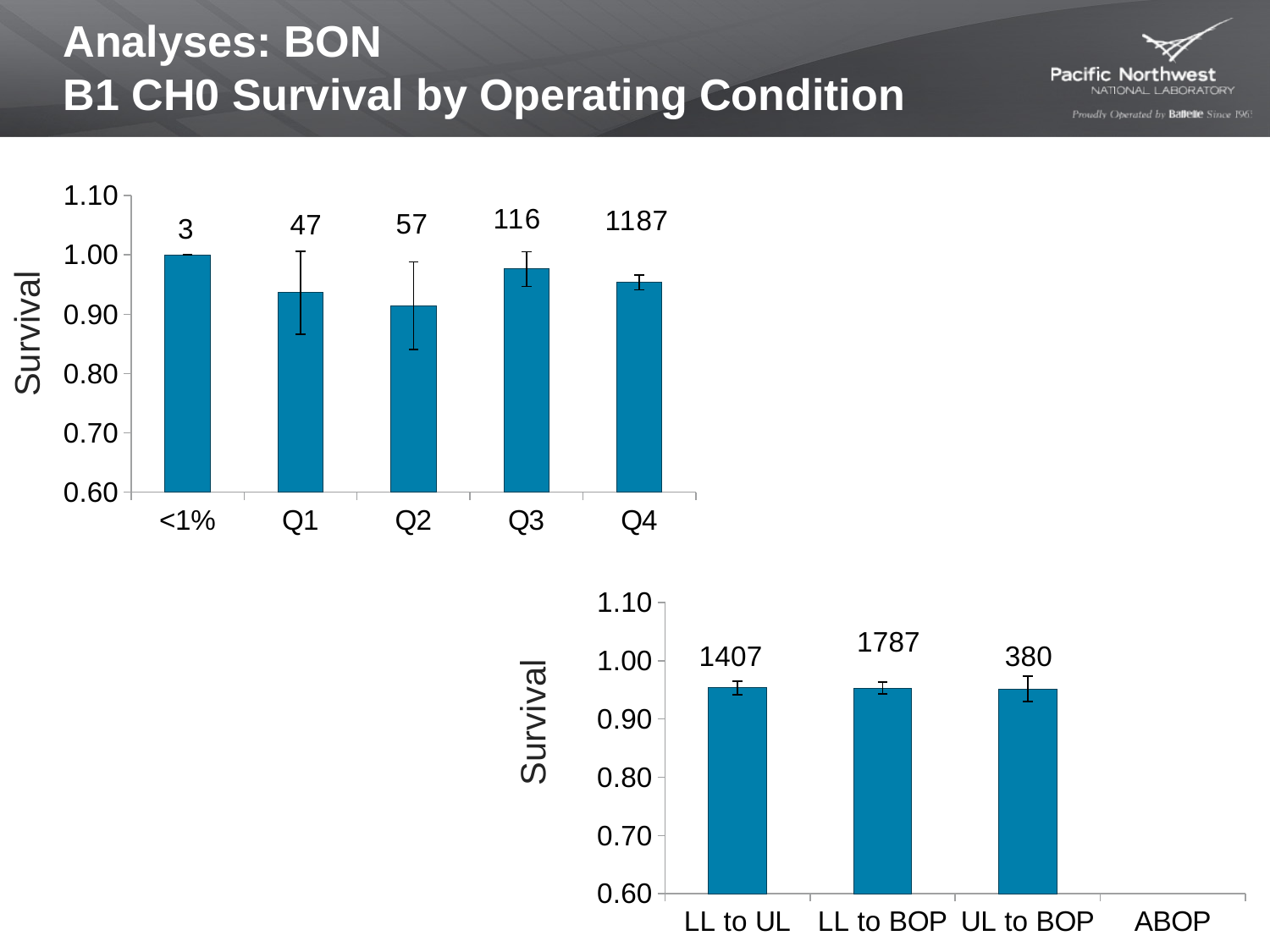
How many categories are labelled on the x axis of the bottom-right chart? 4 In the top-left chart, which category has the highest survival bar? <1% How many bars are plotted in the top-left chart? 5 In the top-left chart, which category has the lowest survival bar? Q2 In the bottom-right chart, what number is printed above the UL to BOP bar? 380 In the top-left chart, what number is printed above the Q4 bar? 1187 In the top-left chart, what number is printed above the Q1 bar? 47 In the bottom-right chart, is the survival value for LL to UL greater or less than 0.90? greater In the bottom-right chart, what number is printed above the LL to BOP bar? 1787 In the top-left chart, is the survival value for Q3 greater or less than 1.00? less What type of chart is the top-left chart? Bar chart In the top-left chart, is the survival value for Q2 greater or less than 0.90? greater